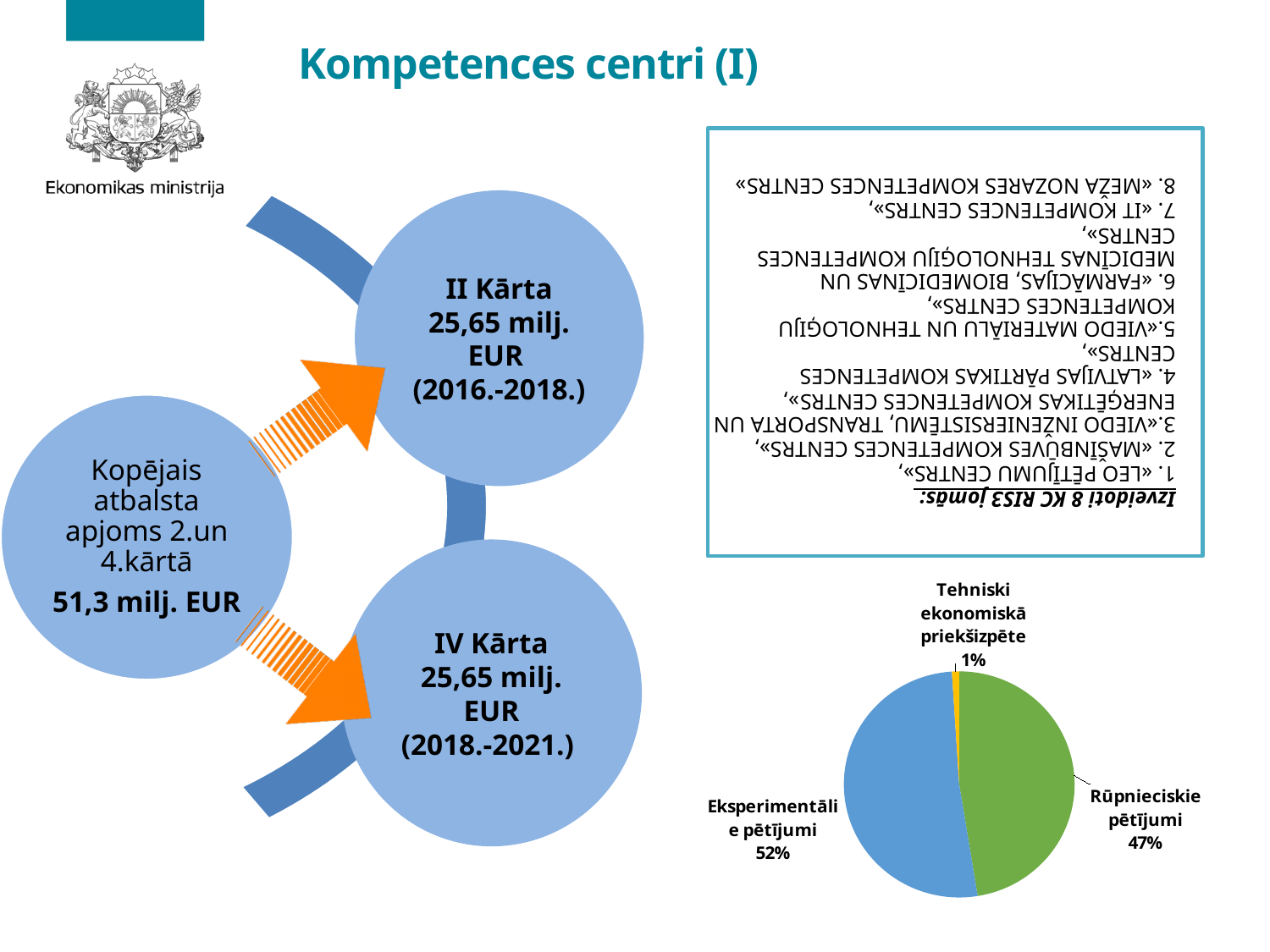
What colour is the Rūpnieciskie pētījumi slice in the pie chart? green Which slice of the pie chart is the smallest? Tehniski ekonomiskā priekšizpēte How many slices does the pie chart have? 3 What is the difference in percentage points between the Rūpnieciskie pētījumi slice and the Tehniski ekonomiskā priekšizpēte slice? 46 What colour is the Eksperimentālie pētījumi slice in the pie chart? blue What kind of chart is shown at the bottom right of the slide? pie chart What share of the pie chart is labelled Eksperimentālie pētījumi? 52% Which is larger in the pie chart, Rūpnieciskie pētījumi or Tehniski ekonomiskā priekšizpēte? Rūpnieciskie pētījumi Which slice of the pie chart is the largest? Eksperimentālie pētījumi What share of the pie chart is labelled Tehniski ekonomiskā priekšizpēte? 1% What share of the pie chart is labelled Rūpnieciskie pētījumi? 47% What is the difference in percentage points between the Eksperimentālie pētījumi slice and the Rūpnieciskie pētījumi slice? 5